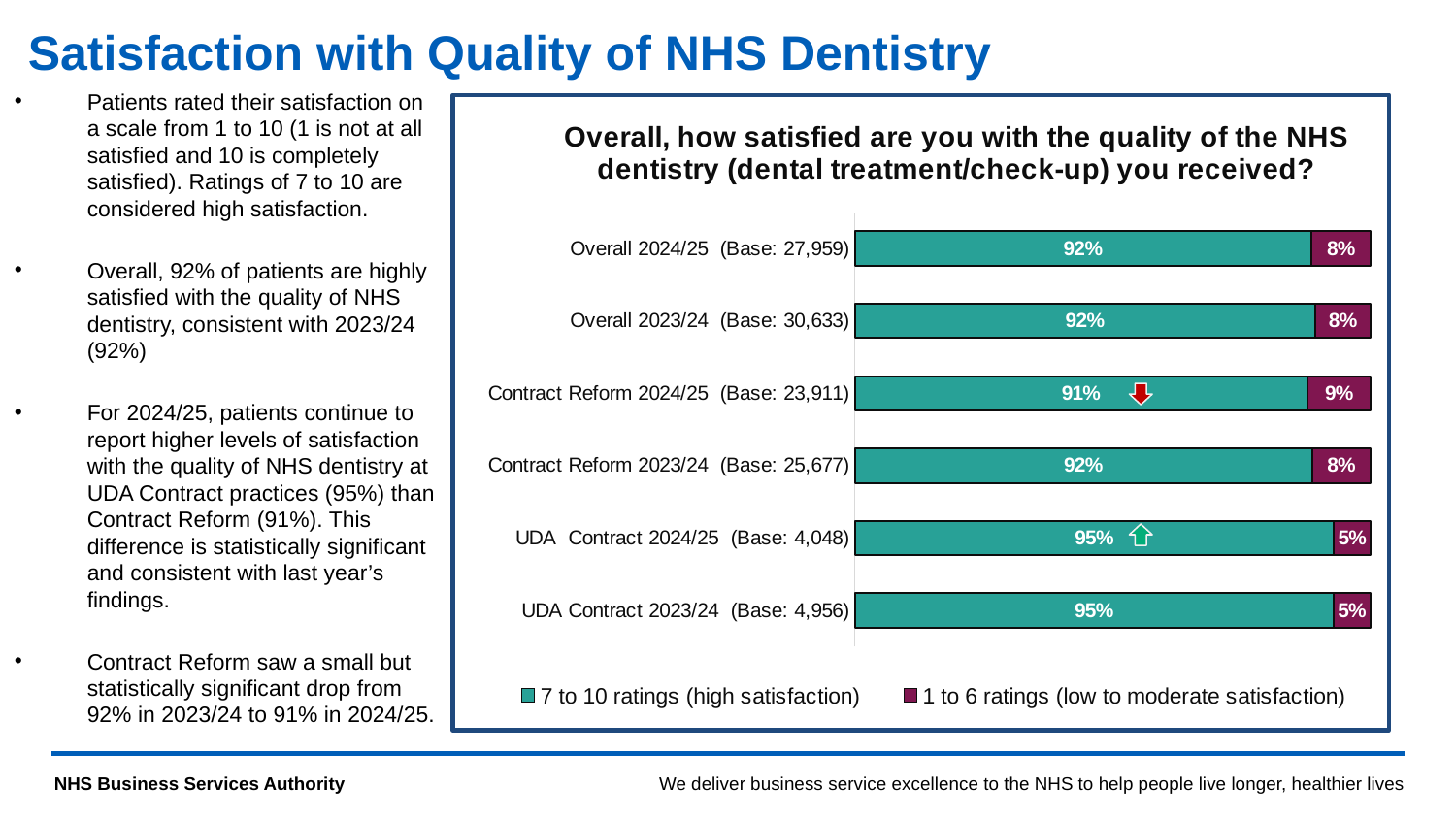
What is the difference in the 7 to 10 ratings (high satisfaction) percentage between UDA Contract 2024/25 and Contract Reform 2024/25? 4% How many series does the legend list? 2 What percentage of patients gave 7 to 10 ratings (high satisfaction) for UDA Contract 2023/24? 95% What is the base (number of respondents) shown for UDA Contract 2024/25? 4,048 Which has a higher percentage of 7 to 10 ratings (high satisfaction): Contract Reform 2023/24 or Contract Reform 2024/25? Contract Reform 2023/24 What is the title of the chart? Overall, how satisfied are you with the quality of the NHS dentistry (dental treatment/check-up) you received? What percentage of patients gave 1 to 6 ratings (low to moderate satisfaction) for Contract Reform 2024/25? 9% Which category has the highest percentage of 1 to 6 ratings (low to moderate satisfaction)? Contract Reform 2024/25 What is the total of the stacked bar for Overall 2023/24? 100% What kind of chart is shown on the slide? Stacked bar chart What percentage of patients gave 7 to 10 ratings (high satisfaction) for Overall 2024/25? 92% How many categories are shown on the chart? 6